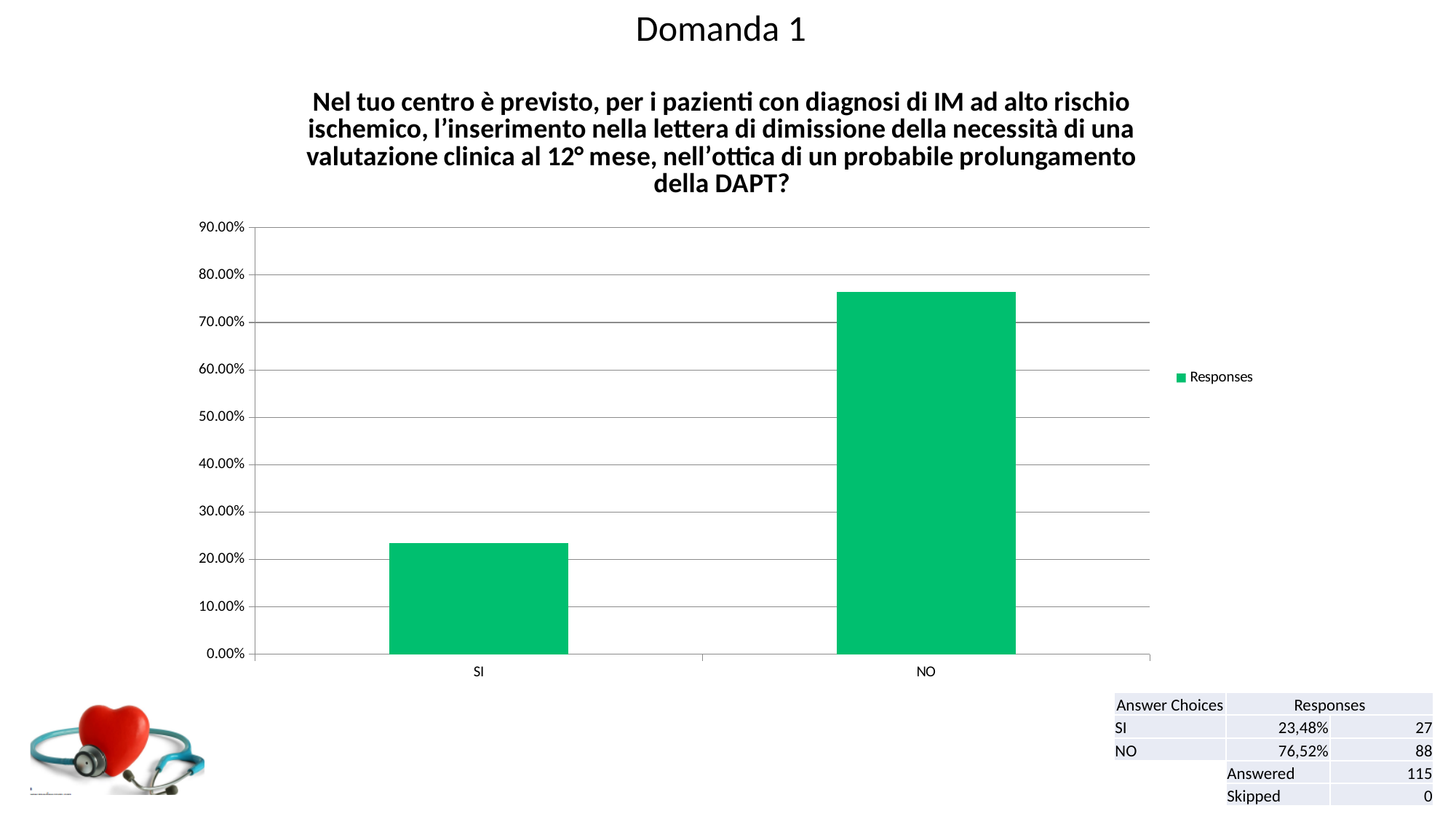
Using the percentages in the table, what is the difference between the NO and SI responses? 53,04% Which category has the lowest value in the chart? SI How many categories are shown on the x axis of the chart? 2 What is the name of the series shown in the chart legend? Responses According to the table on the slide, what percentage of responses was NO? 76,52% Is the value for SI greater or less than 30.00%? less How many series does the chart legend list? 1 What kind of chart is shown on the slide? bar chart According to the table on the slide, what percentage of responses was SI? 23,48% Is the value for NO greater or less than 70.00%? greater Which category has the highest value in the chart? NO Which is larger, the value for SI or the value for NO? NO